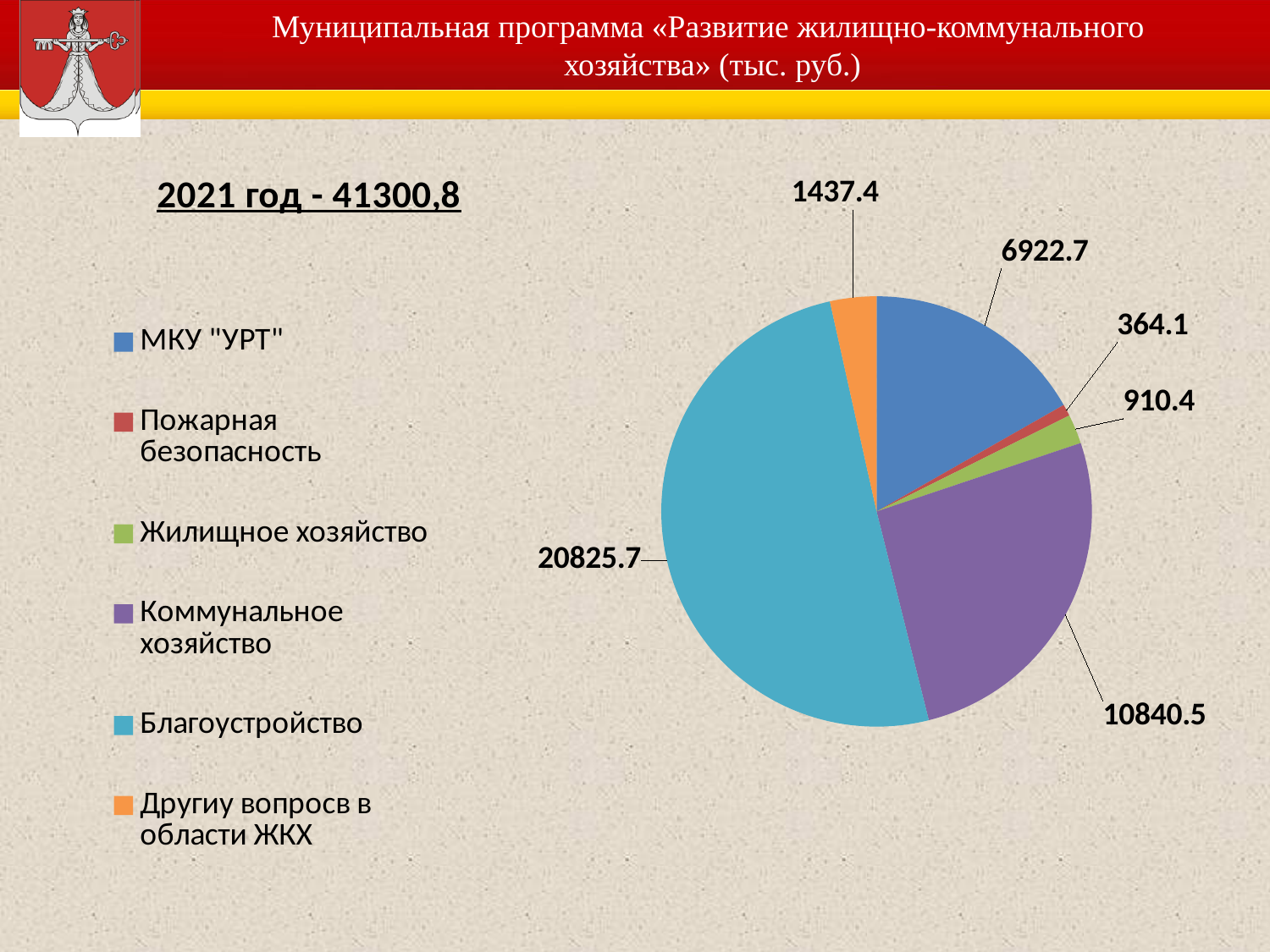
Which category has the largest slice of the pie? Благоустройство What is the difference between the values for Благоустройство and Коммунальное хозяйство? 9985.2 What is the value for Коммунальное хозяйство? 10840.5 What total for 2021 is stated on the slide? 41300,8 How many categories does the pie chart have? 6 What is the value for Жилищное хозяйство? 910.4 What is the value for Благоустройство? 20825.7 What type of chart is shown on the slide? pie chart What is the value for МКУ "УРТ"? 6922.7 Which is larger, the value for МКУ "УРТ" or the value for Другиу вопросв в области ЖКХ? МКУ "УРТ" Which category has the smallest slice of the pie? Пожарная безопасность What is the value for Пожарная безопасность? 364.1